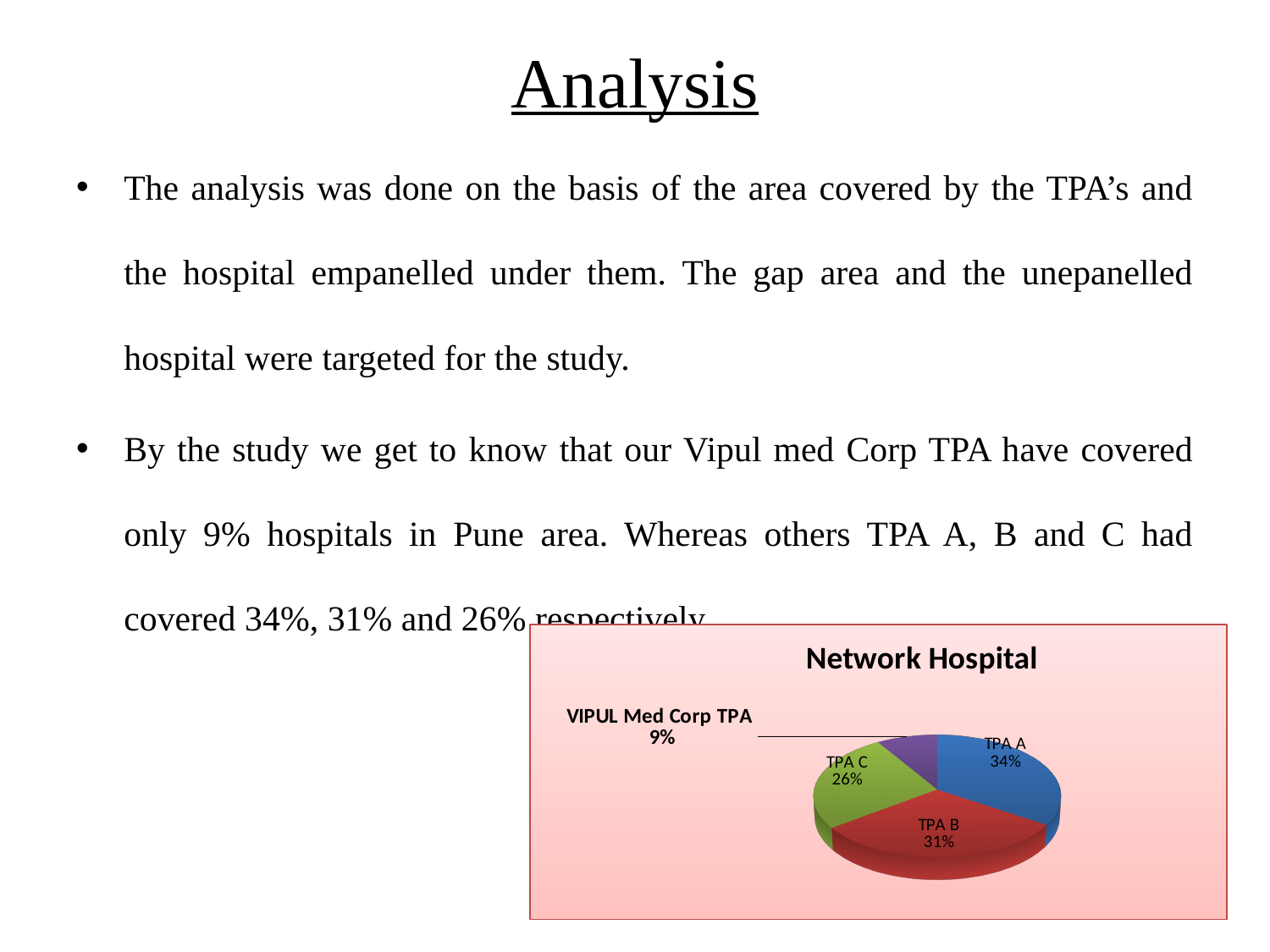
Which slice of the pie is the largest? TPA A What share of the pie does TPA C hold? 26% What type of chart is shown on the slide? pie chart What is the title of the chart? Network Hospital Which slice of the pie is the smallest? VIPUL Med Corp TPA How many slices does the pie chart have? 4 What share of the pie does TPA A hold? 34% Which is larger, the share for TPA B or the share for TPA C? TPA B What is the difference in percentage points between TPA A and VIPUL Med Corp TPA? 25 What share of the pie does VIPUL Med Corp TPA hold? 9% What share of the pie does TPA B hold? 31% What colour is the TPA B slice? red